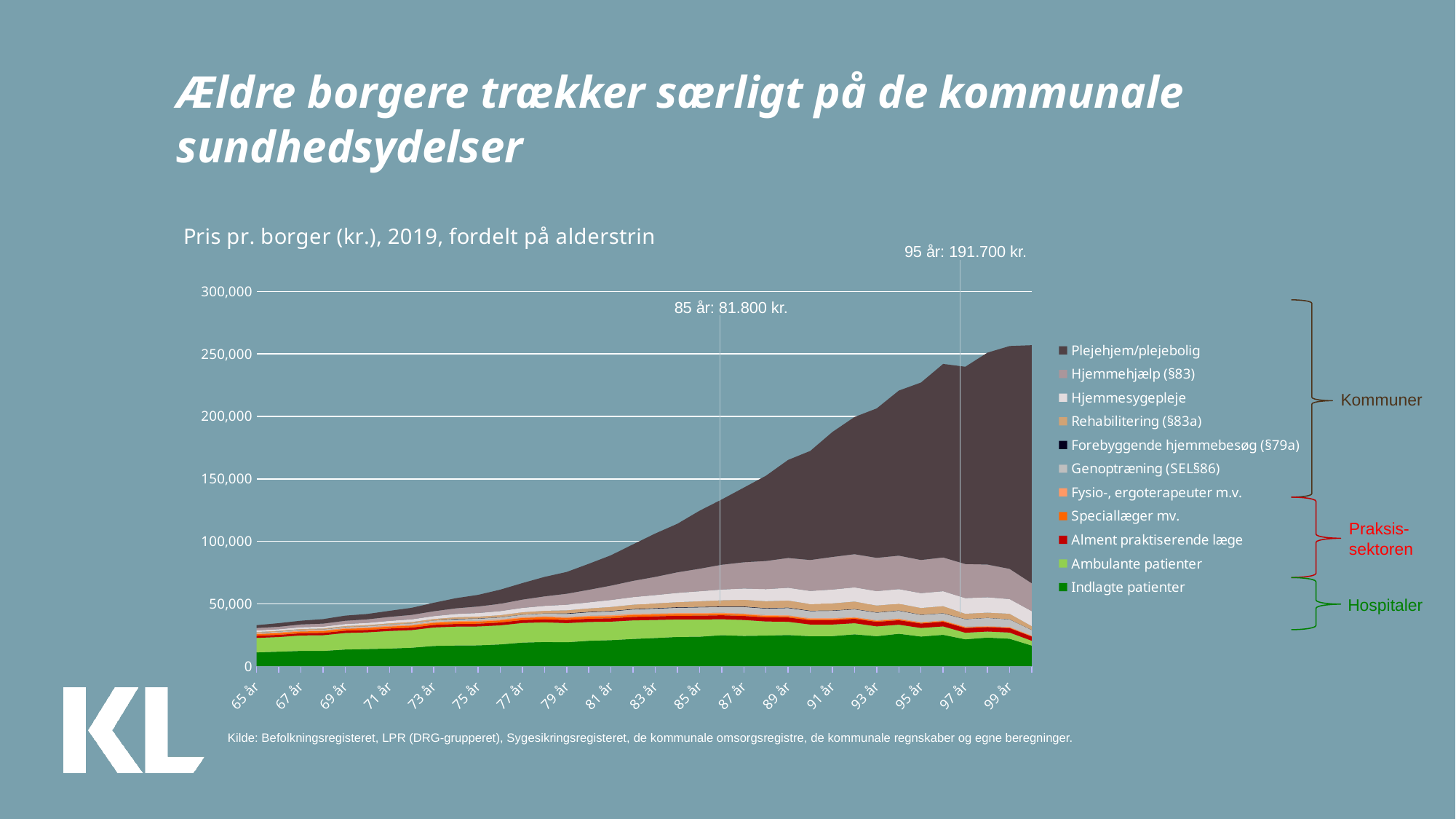
Does the total price per citizen rise or fall as age increases along the x axis? Rises Is the total value for 81 år greater or less than 100,000? less How many age labels are shown on the x axis? 18 What kind of chart is shown on the slide? Stacked area chart Is the total value for 85 år greater or less than 100,000? greater Is the total value for 65 år greater or less than 50,000? less How many series does the chart legend list? 11 What is the title of the chart? Pris pr. borger (kr.), 2019, fordelt på alderstrin What annotated value is shown for 95 år on the chart? 191.700 kr. Which is larger, the total value for 95 år or for 75 år? 95 år Which age group has the lowest total price per citizen? 65 år